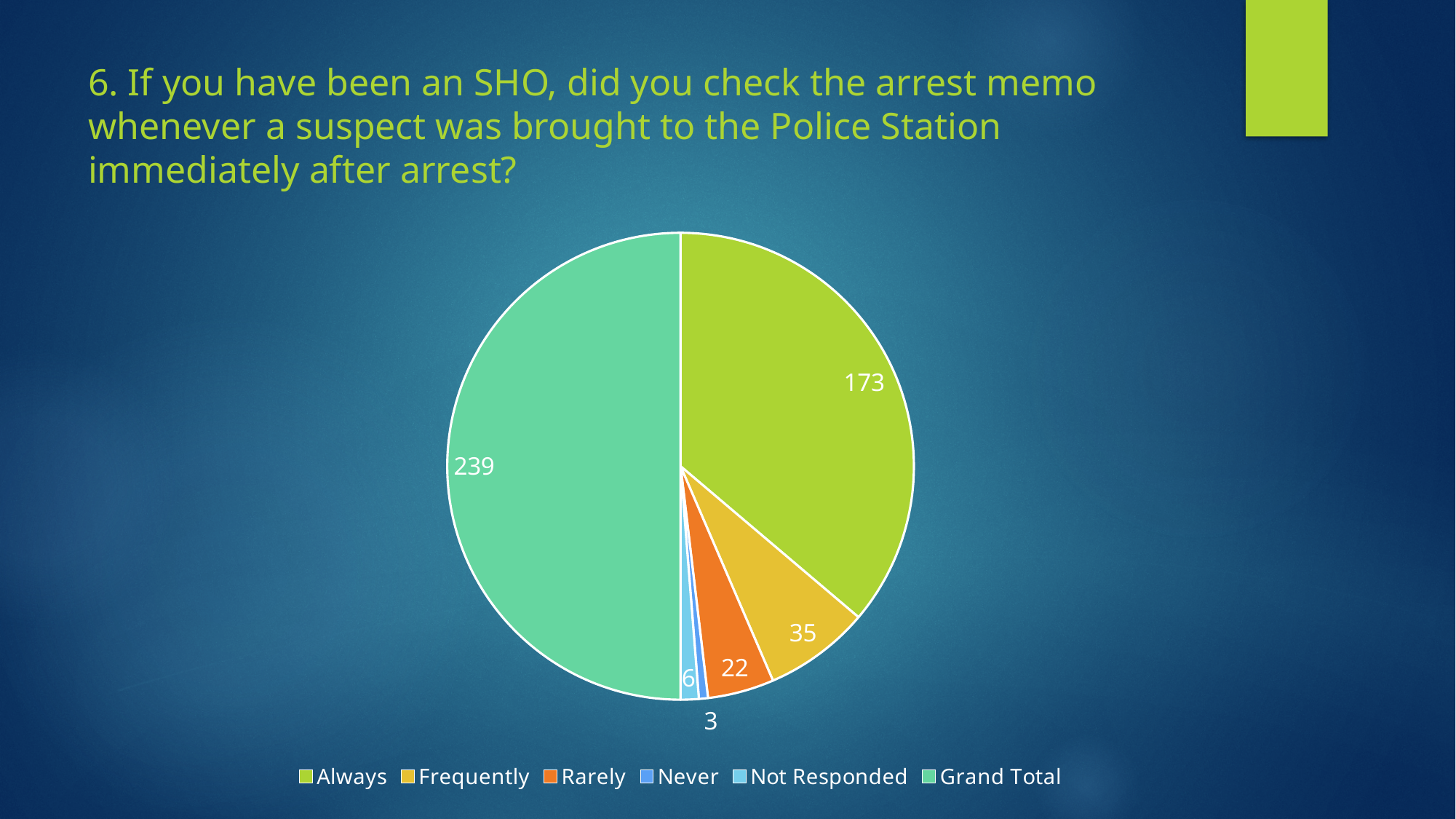
Which category has the smallest slice? Never What is the value for Never? 3 How many entries does the legend list? 6 What is the value for Grand Total? 239 What is the value for Rarely? 22 What is the value for Not Responded? 6 What is the value for Frequently? 35 Which category has the largest slice? Grand Total What type of chart is shown on the slide? pie chart What is the difference between the values for Always and Frequently? 138 What is the value for Always? 173 Which is larger, the value for Rarely or the value for Not Responded? Rarely